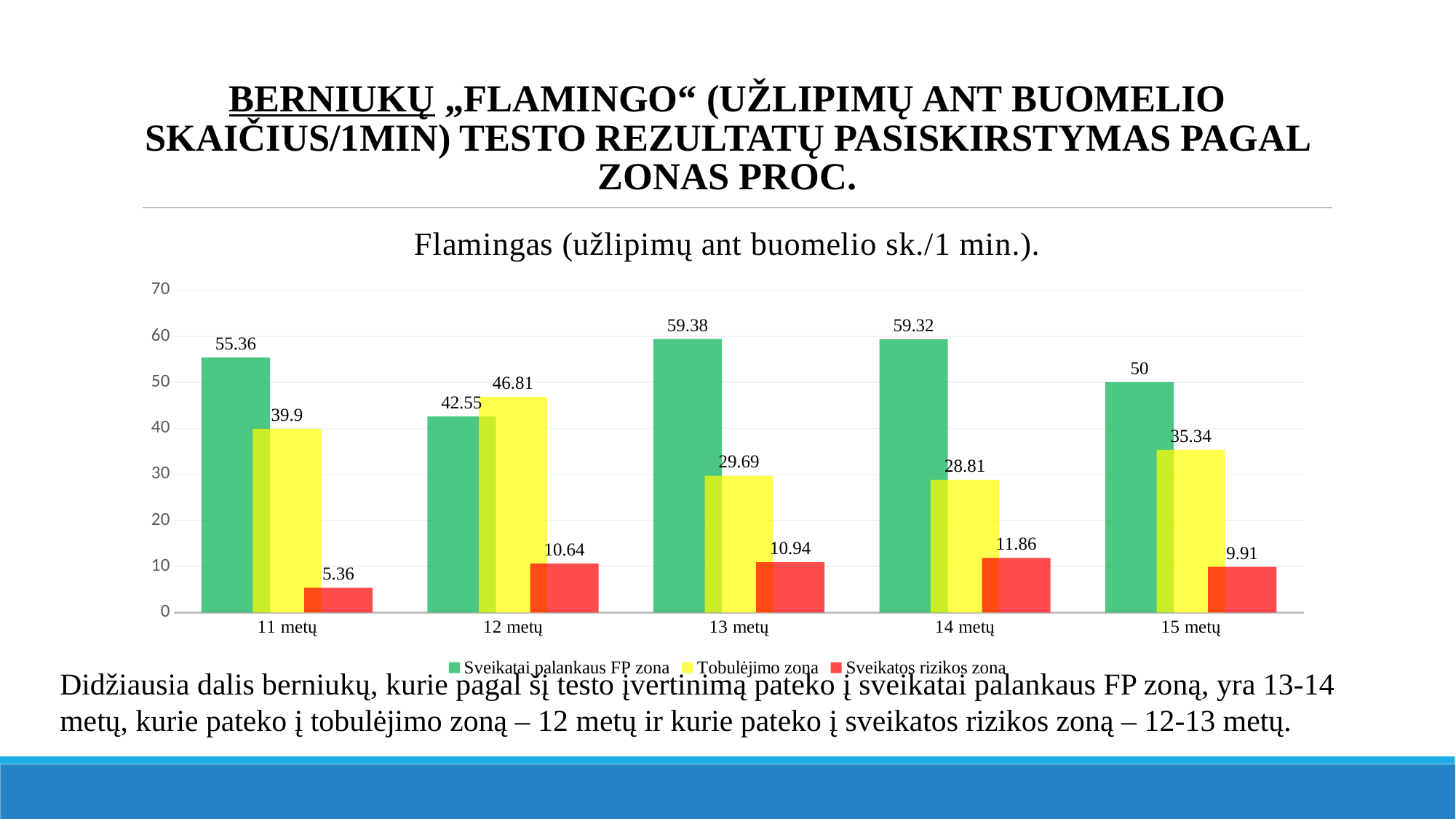
What kind of chart is shown on the slide? bar chart Which age group has the lowest value for Sveikatai palankaus FP zona? 12 metų What is the value for Tobulėjimo zona at 13 metų? 29.69 Which age group has the lowest value for Sveikatos rizikos zona? 11 metų At 12 metų, which is larger: Sveikatai palankaus FP zona or Tobulėjimo zona? Tobulėjimo zona What is the difference between Sveikatai palankaus FP zona and Tobulėjimo zona at 11 metų? 15.46 What is the value for Sveikatai palankaus FP zona at 11 metų? 55.36 Which age group has the highest value for Tobulėjimo zona? 12 metų What is the value for Sveikatai palankaus FP zona at 15 metų? 50 What is the value for Sveikatos rizikos zona at 14 metų? 11.86 How many age groups are shown on the x axis? 5 How many series does the legend list? 3